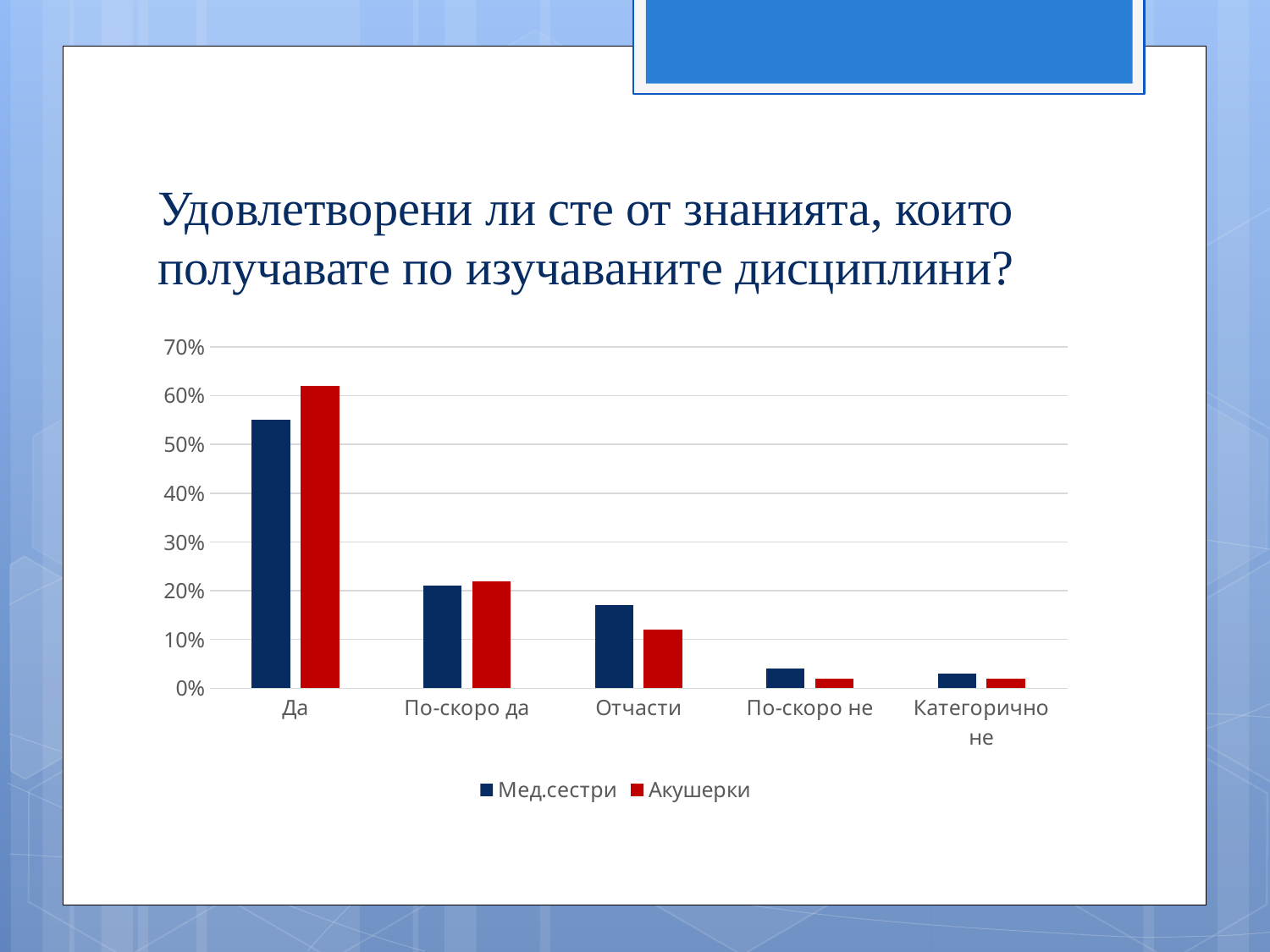
How many response categories are shown on the x axis? 5 Is the value for Акушерки in the category Отчасти greater or less than 20%? less How many series does the legend list? 2 Is the value for Мед.сестри in the category По-скоро да greater or less than 10%? greater Which category has the highest value for Мед.сестри? Да Is the value for Мед.сестри in the category Да greater or less than 50%? greater Which category has the highest value for Акушерки? Да What kind of chart is shown on the slide? bar chart For the category Отчасти, which series has the larger value, Мед.сестри or Акушерки? Мед.сестри What colour are the bars for the Акушерки series? red For the category По-скоро не, which series has the larger value, Мед.сестри or Акушерки? Мед.сестри For the category Да, which series has the larger value, Мед.сестри or Акушерки? Акушерки